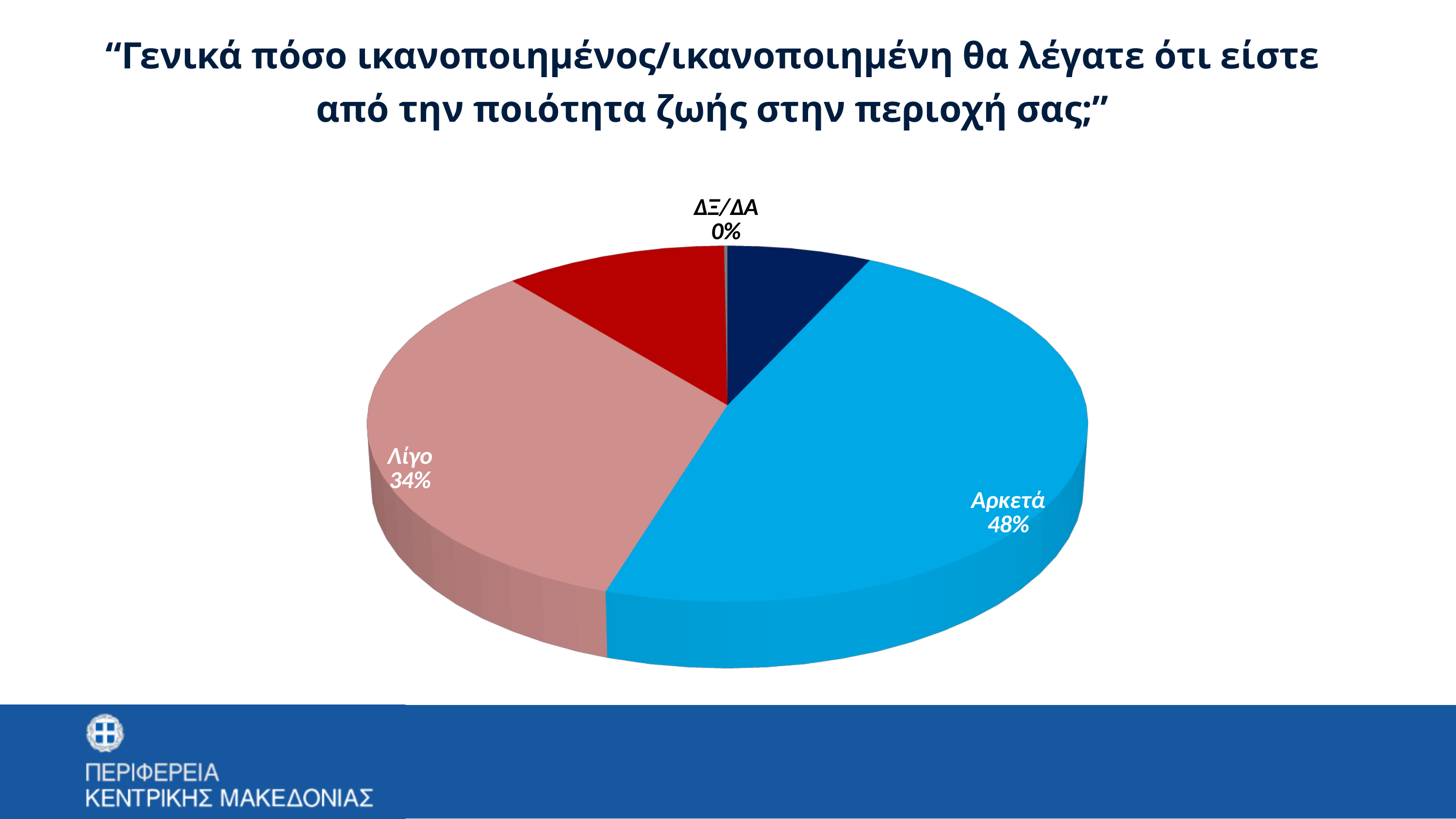
Which labelled response has the smallest share of the pie? ΔΞ/ΔΑ What colour is the Λίγο slice? Pink What kind of chart is shown on the slide? Pie chart Which labelled response has the largest share of the pie? Αρκετά What percentage of respondents answered Αρκετά? 48% What percentage of respondents answered Λίγο? 34% Which is larger, the share for Αρκετά or the share for Λίγο? Αρκετά By how many percentage points does Αρκετά exceed Λίγο? 14 percentage points What percentage is shown for ΔΞ/ΔΑ? 0% What is the combined share of Αρκετά and Λίγο? 82% What share of the pie does the Αρκετά slice represent? 48% What colour is the Αρκετά slice? Light blue